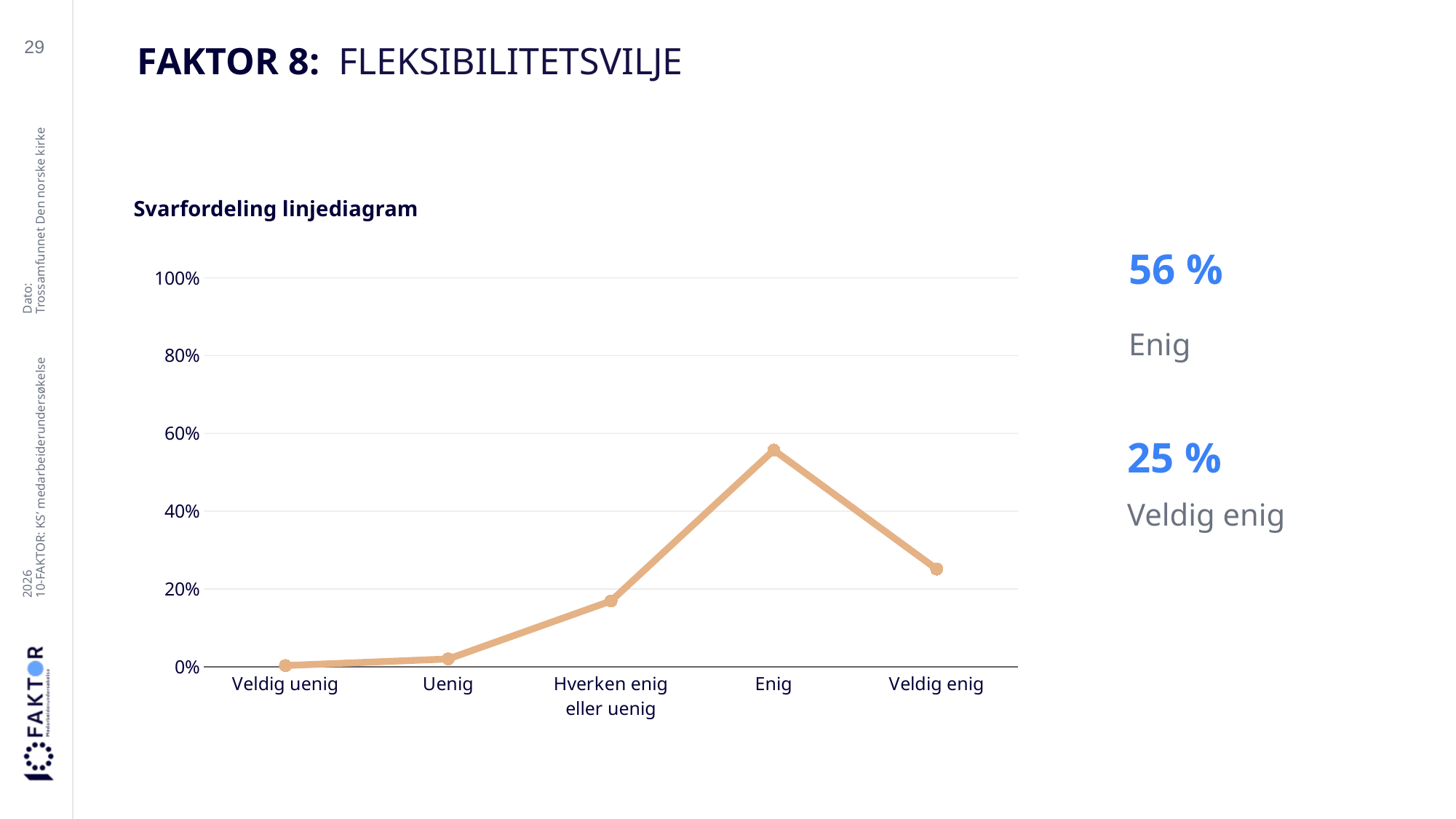
What is the value for Veldig enig? 25 % What is the difference between the values for Enig and Veldig enig? 31 % Which category has the highest value in the chart? Enig Which is larger, the value for Enig or the value for Veldig enig? Enig Which category has the lowest value in the chart? Veldig uenig What kind of chart is shown on the slide? line chart Is the value for Uenig greater or less than 20%? less Is the value for Hverken enig eller uenig greater or less than 20%? less What is the title of the chart? Svarfordeling linjediagram How many categories are shown on the x axis of the chart? 5 What is the value for Enig? 56 % How do the values change along the x axis from Veldig uenig to Veldig enig? They rise up to Enig, then fall